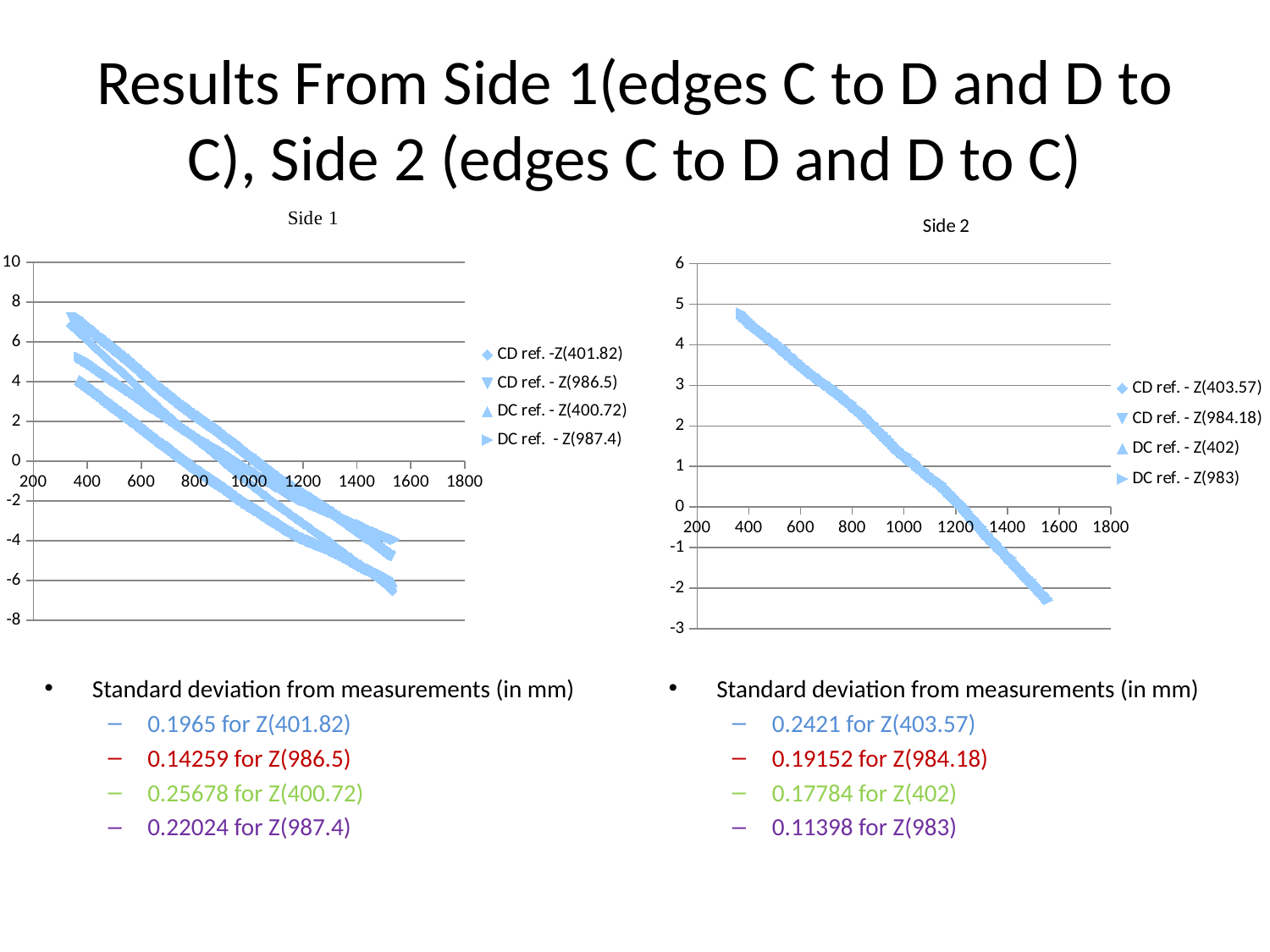
How many series does the legend of the "Side 1" chart list? 4 What kind of chart is the "Side 1" chart? scatter chart In the "Side 1" chart, are the plotted values at x = 1400 greater or less than 0? less In the "Side 2" chart, is the plotted value at x = 400 greater or less than 4? greater What is the first legend entry of the "Side 2" chart? CD ref. - Z(403.57) In the "Side 2" chart, is the plotted value at x = 1400 greater or less than 0? less In the "Side 1" chart, do the plotted values rise or fall as the x axis increases? fall What is the highest value shown on the y axis of the "Side 1" chart? 10 In the "Side 2" chart, do the plotted values rise or fall as the x axis increases? fall How many series does the legend of the "Side 2" chart list? 4 What kind of chart is the "Side 2" chart? scatter chart